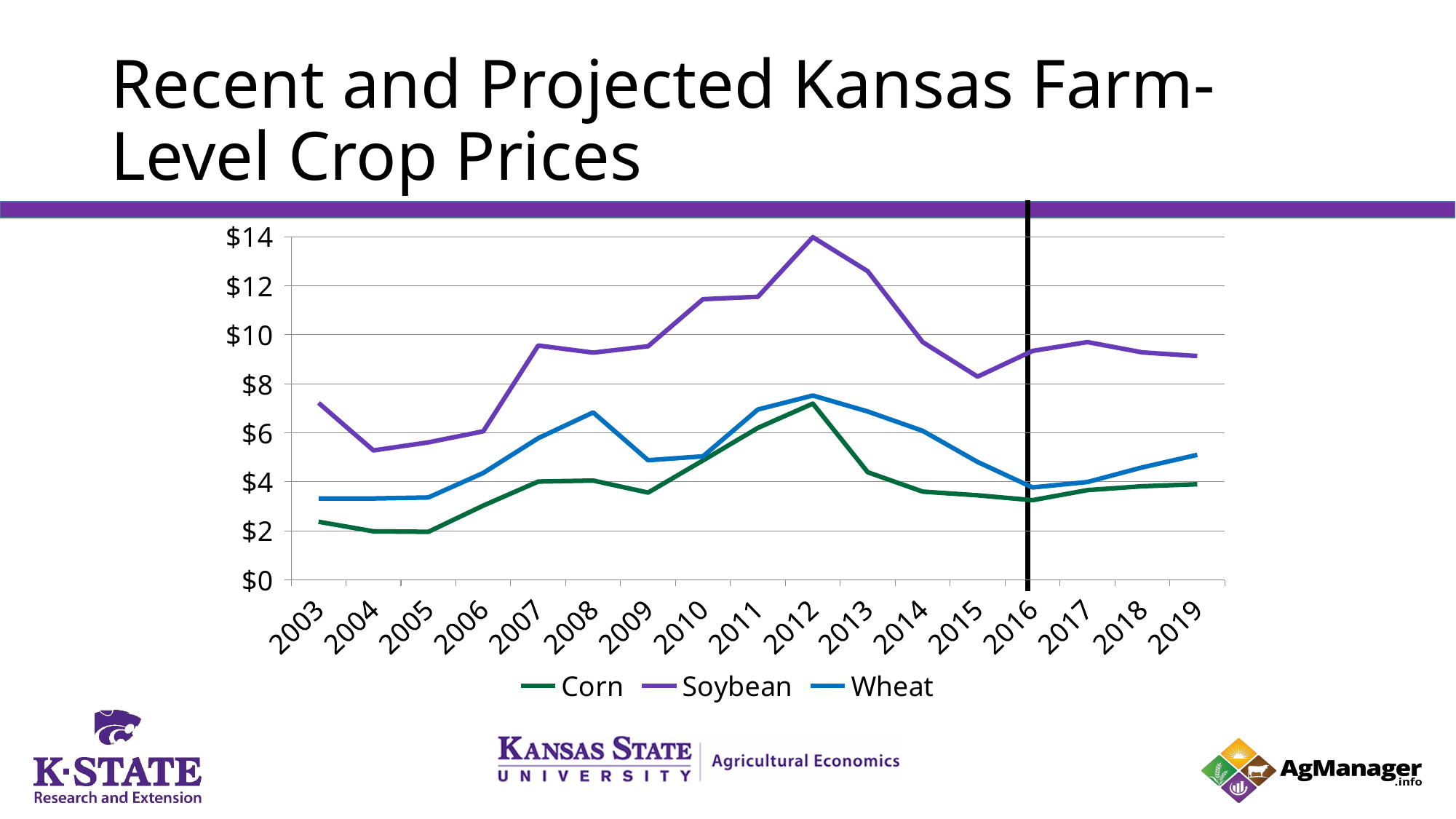
Is the Corn price in 2012 greater or less than $6? greater In 2010, which is higher, the Soybean price or the Corn price? Soybean How many years are shown on the x axis? 17 Is the Soybean price in 2012 greater or less than $12? greater Does the Soybean price rise or fall from 2012 to 2015? Fall Is the Wheat price in 2008 greater or less than $6? greater In which year does the Soybean price reach its highest point? 2012 What kind of chart is shown on the slide? Line chart Which series does the legend list: name them. Corn, Soybean, Wheat How many series does the legend list? 3 In which year is the Soybean price at its lowest? 2004